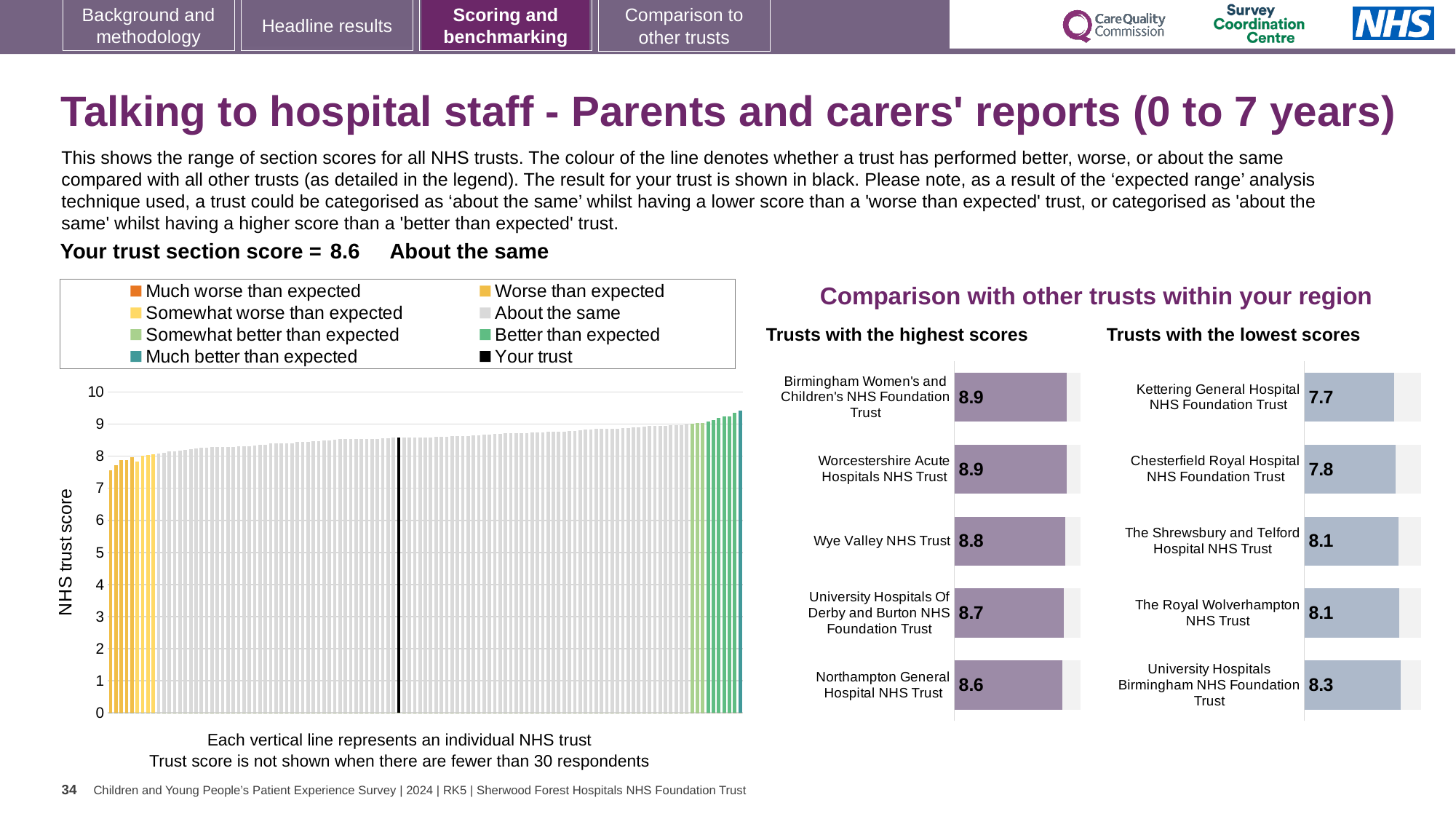
What kind of chart is the large 'NHS trust score' chart on the left of the slide? Bar chart How many entries does the legend above the 'NHS trust score' chart list? 8 In the legend of the 'NHS trust score' chart, what colour represents 'Your trust'? Black In the 'Trusts with the lowest scores' chart, what is the score for Kettering General Hospital NHS Foundation Trust? 7.7 What is the section score for your trust shown on the slide? 8.6 In the 'Trusts with the lowest scores' chart, which has the higher score: Chesterfield Royal Hospital NHS Foundation Trust or University Hospitals Birmingham NHS Foundation Trust? University Hospitals Birmingham NHS Foundation Trust In the 'Trusts with the highest scores' chart, what is the score for Wye Valley NHS Trust? 8.8 How many trusts are listed in the 'Trusts with the highest scores' chart? 5 In the 'Trusts with the lowest scores' chart, what is the difference between the scores of The Shrewsbury and Telford Hospital NHS Trust and Kettering General Hospital NHS Foundation Trust? 0.4 In the 'Trusts with the lowest scores' chart, which trust has the lowest score? Kettering General Hospital NHS Foundation Trust In the 'Trusts with the highest scores' chart, what is the difference between the scores of Birmingham Women's and Children's NHS Foundation Trust and Northampton General Hospital NHS Trust? 0.3 In the 'NHS trust score' chart on the left, is the value of the lowest (leftmost) bar greater or less than 8? less